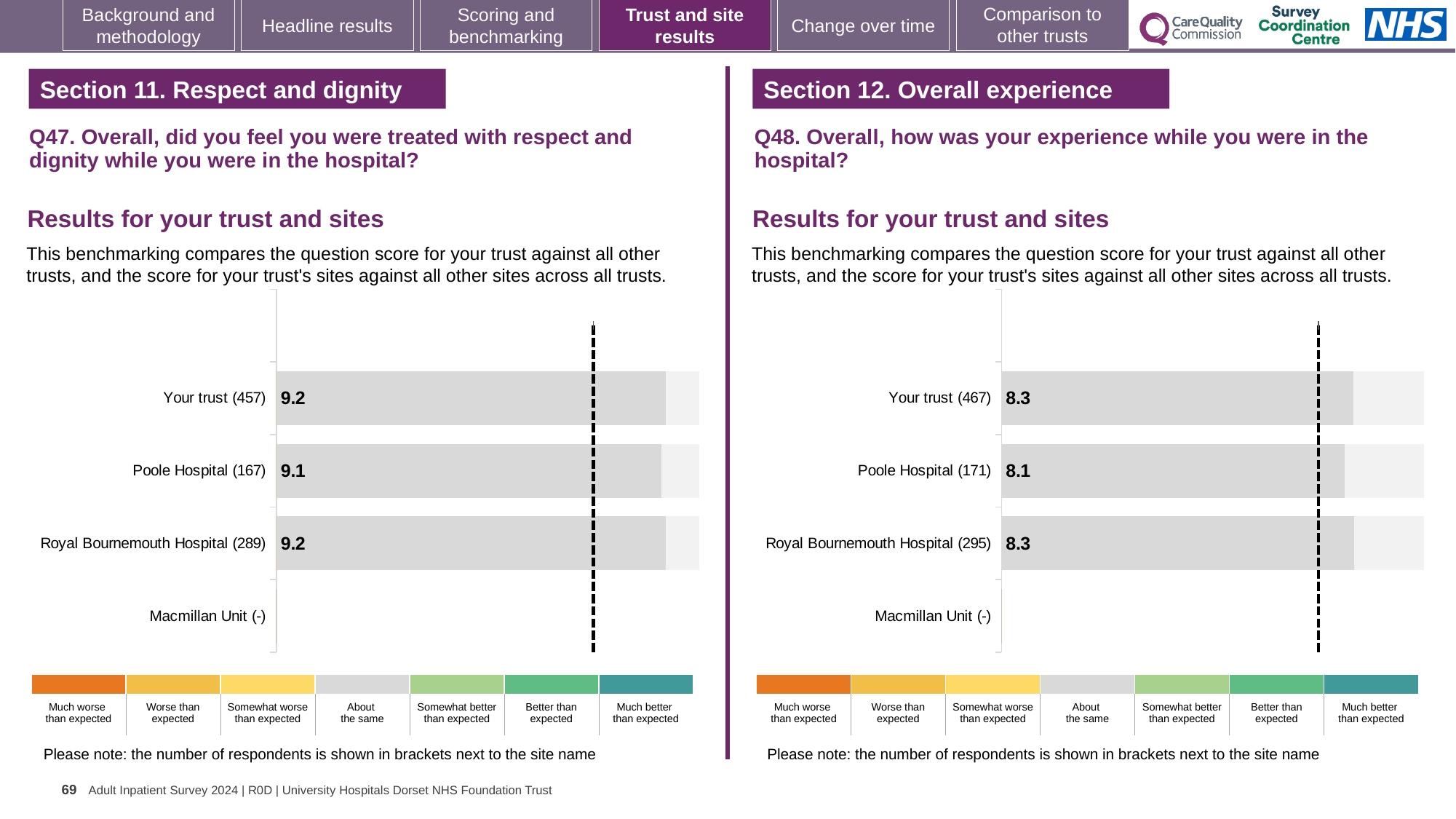
What kind of chart is used on the Q48 chart (Section 12, right)? Bar chart How many site/trust categories are listed on the Q47 chart (Section 11, left)? 4 On the Q48 chart (Section 12, right), which has the higher score, Your trust or Poole Hospital? Your trust On the Q48 chart (Section 12, right), what is the difference between the scores for Your trust and Poole Hospital? 0.2 On the Q48 chart (Section 12, right), which site has the lowest score among those with a value shown? Poole Hospital On the Q47 chart (Section 11, left), how many respondents are shown in brackets for Royal Bournemouth Hospital? 289 On the Q47 chart (Section 11, left), which site has the lowest score among those with a value shown? Poole Hospital On the Q47 chart (Section 11, left), what is the score for Poole Hospital? 9.1 On the Q48 chart (Section 12, right), what is the score for Royal Bournemouth Hospital? 8.3 On the Q47 chart (Section 11, left), what is the score for Your trust? 9.2 On the Q47 chart (Section 11, left), what is the difference between the scores for Royal Bournemouth Hospital and Poole Hospital? 0.1 On the Q48 chart (Section 12, right), what is the score for Poole Hospital? 8.1